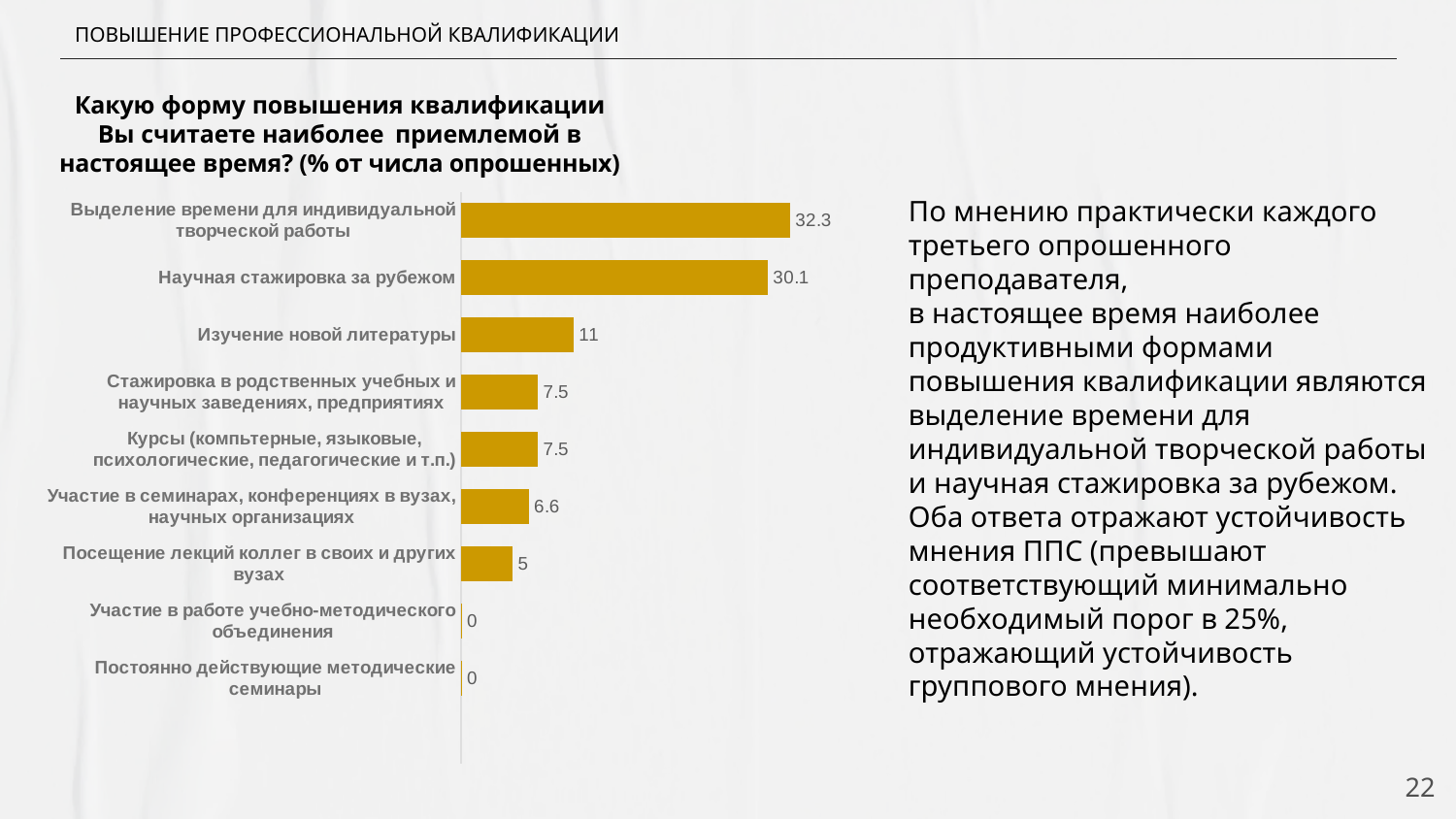
Which category has the highest value? Выделение времени для индивидуальной творческой работы Which is larger: the value for «Изучение новой литературы» or the value for «Стажировка в родственных учебных и научных заведениях, предприятиях»? Изучение новой литературы What value is shown for «Посещение лекций коллег в своих и других вузах»? 5 What value is shown for «Изучение новой литературы»? 11 What colour are the bars in the chart? Gold (dark yellow) What is the difference between the values for «Изучение новой литературы» and «Участие в семинарах, конференциях в вузах, научных организациях»? 4.4 How many categories are shown in the chart? 9 How many categories have a value of 0? 2 What value is shown for «Участие в работе учебно-методического объединения»? 0 What kind of chart is shown on the slide? Bar chart What is the difference between the values for «Выделение времени для индивидуальной творческой работы» and «Научная стажировка за рубежом»? 2.2 What value is shown for «Научная стажировка за рубежом»? 30.1